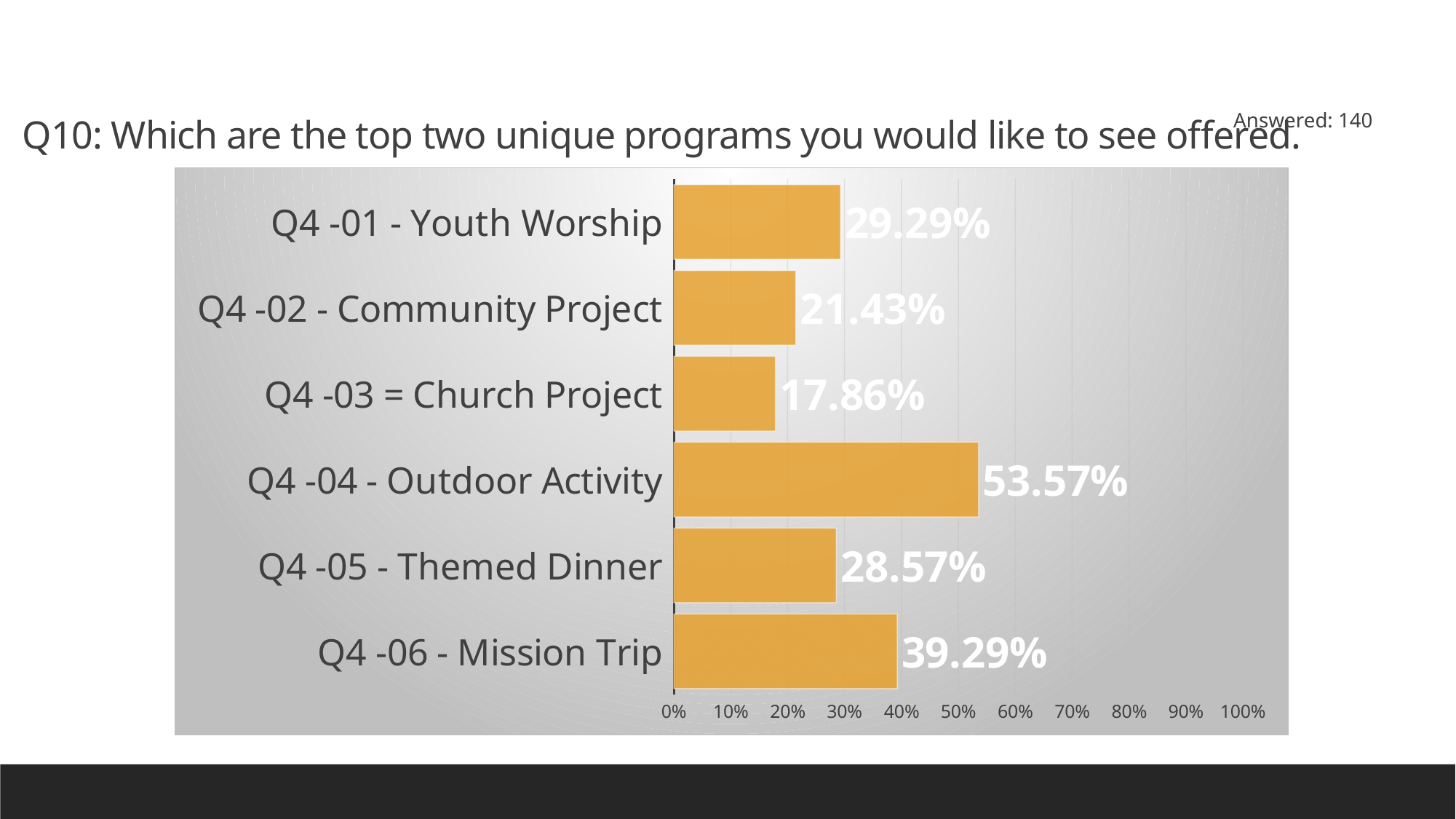
What is the value for Q4 -02 - Community Project? 21.43% What is the difference between the values for Q4 -04 - Outdoor Activity and Q4 -06 - Mission Trip? 14.28% How many respondents answered the question, according to the slide? 140 Is the value for Q4 -04 - Outdoor Activity greater or less than 50%? greater What is the difference between the values for Q4 -01 - Youth Worship and Q4 -03 = Church Project? 11.43% What kind of chart is shown on the slide? bar chart Which category has the lowest value? Q4 -03 = Church Project What is the value for Q4 -06 - Mission Trip? 39.29% Which is larger, the value for Q4 -06 - Mission Trip or the value for Q4 -05 - Themed Dinner? Q4 -06 - Mission Trip Which category has the highest value? Q4 -04 - Outdoor Activity How many categories are shown in the chart? 6 What is the value for Q4 -04 - Outdoor Activity? 53.57%